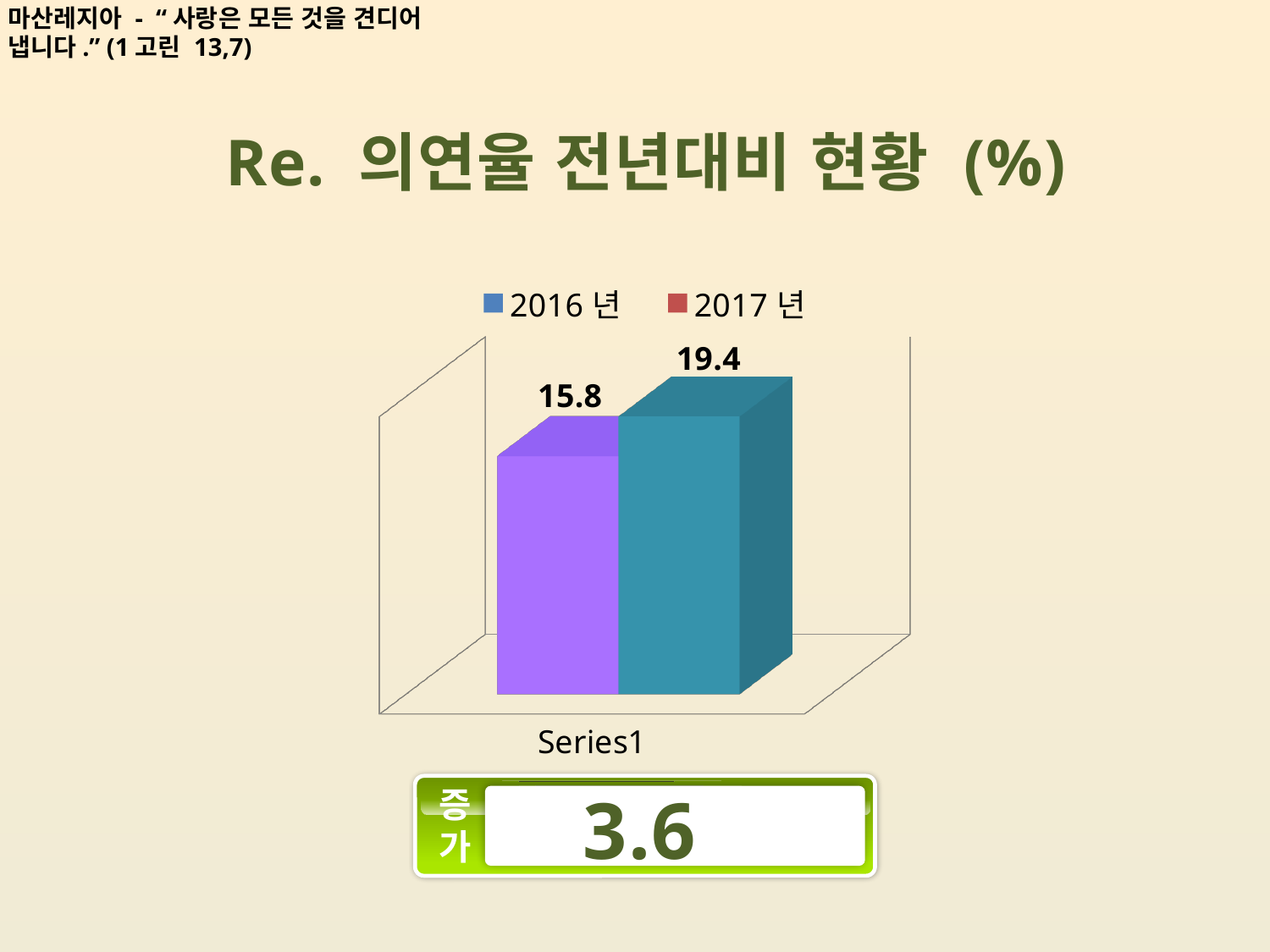
Did the value rise or fall from 2016 년 to 2017 년? rise Which series has the lowest value? 2016 년 Which series has the highest value? 2017 년 What is the difference between the 2017 년 value and the 2016 년 value? 3.6 What kind of chart is shown on the slide? bar chart What is the value for 2017 년? 19.4 How many bars are plotted in the chart? 2 What is the category label shown on the x axis? Series1 What is the value for 2016 년? 15.8 How many series does the legend list? 2 Which series has the higher value, 2016 년 or 2017 년? 2017 년 What is the title of the chart? Re. 의연율 전년대비 현황 (%)